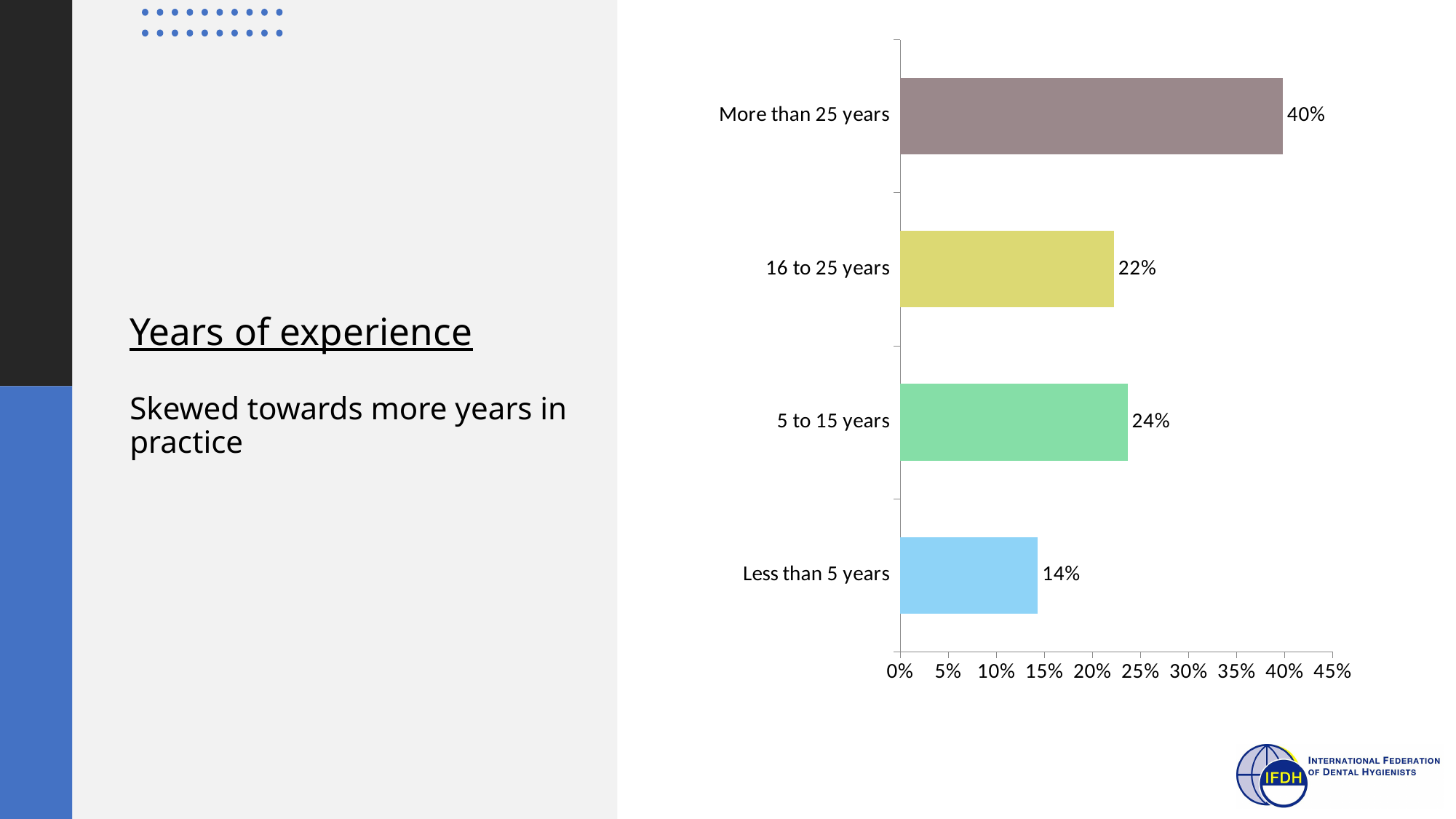
Which category has the lowest value? Less than 5 years What percentage of respondents have less than 5 years of experience? 14% Which category has the highest value? More than 25 years Is the value for 'More than 25 years' greater or less than 35%? greater What is the value shown for the '5 to 15 years' category? 24% Which is larger: the value for '16 to 25 years' or for 'Less than 5 years'? 16 to 25 years What is the difference between the 'More than 25 years' and 'Less than 5 years' values? 26% What kind of chart is shown on the slide? Bar chart What percentage of respondents have more than 25 years of experience? 40% What is the difference between the '5 to 15 years' and '16 to 25 years' values? 2% What is the value shown for the '16 to 25 years' category? 22% How many categories are shown in the chart? 4